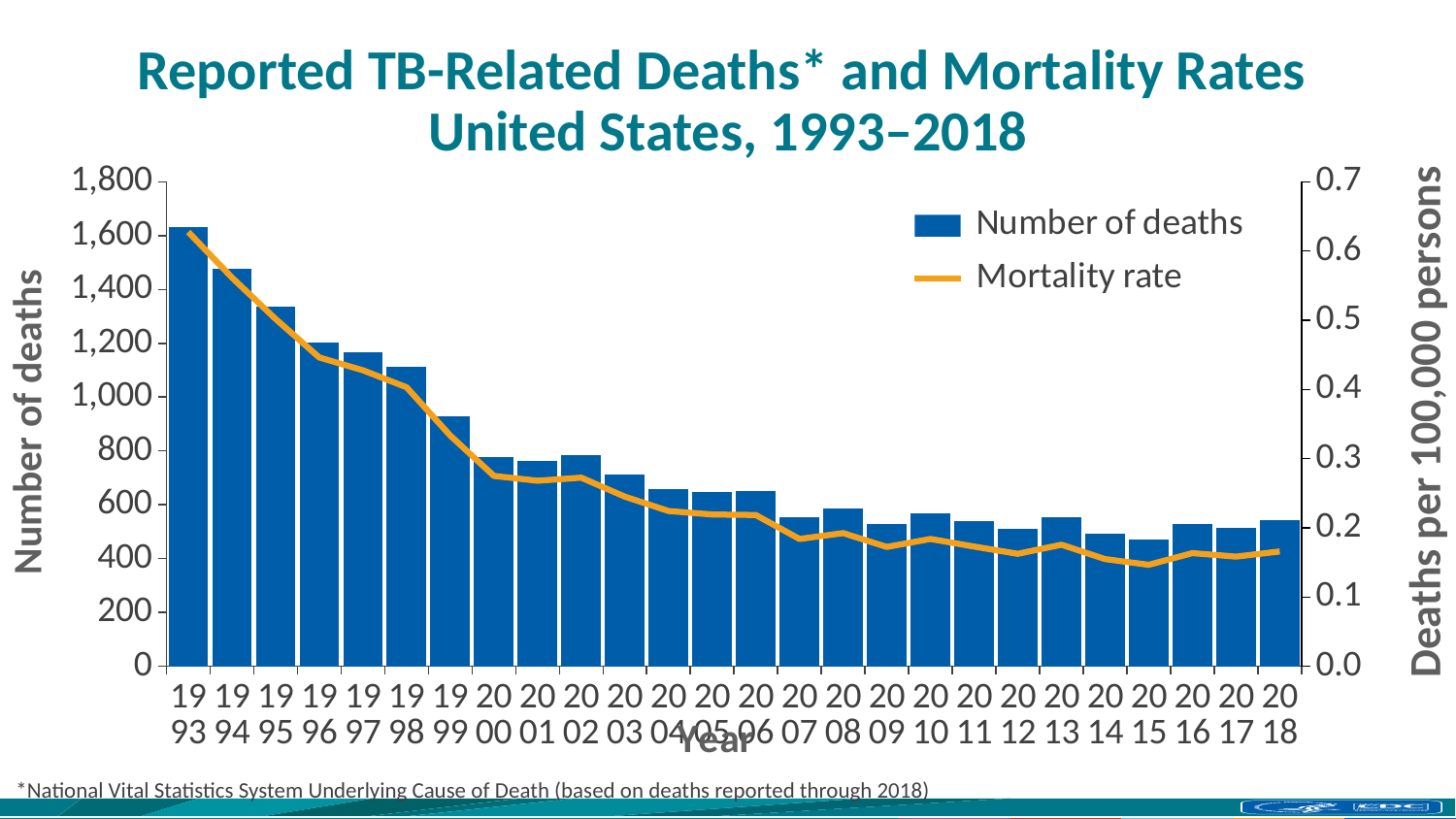
What is the label on the right-hand vertical axis? Deaths per 100,000 persons Do the number of deaths generally rise or fall from 1993 to 2018? fall Is the mortality rate for 2018 greater or less than 0.2 deaths per 100,000 persons? less Is the number of deaths for 2018 greater or less than 600? less What kind of chart is shown on the slide? A combination bar and line chart How many years are shown along the x axis? 26 How many series does the legend list? 2 Is the number of deaths for 1994 greater or less than 1,400? greater Which year has more deaths, 1996 or 2006? 1996 Which year has the highest number of deaths? 1993